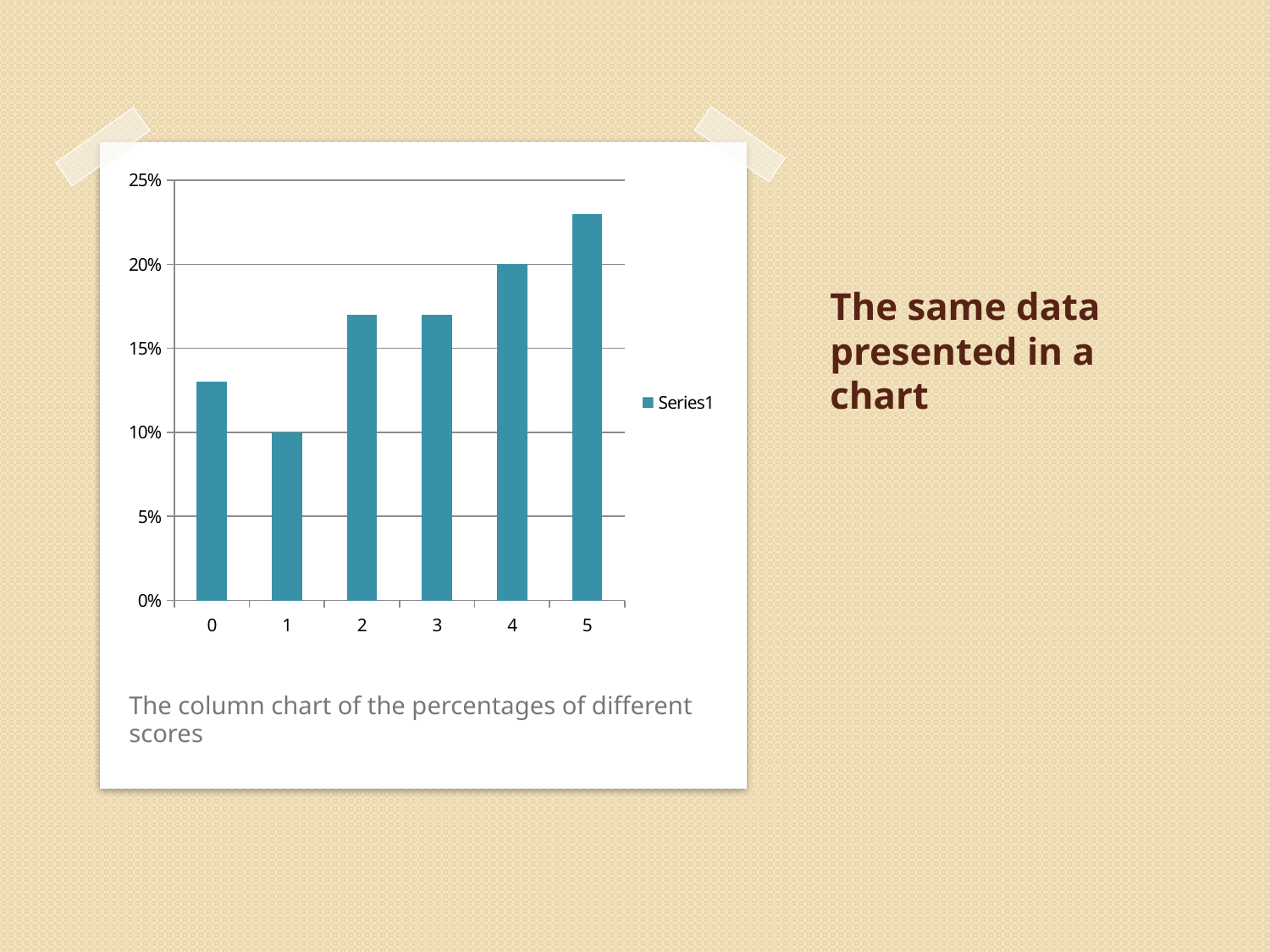
Which is larger, the value for category 0 or the value for category 2? category 2 Which category has the highest bar? 5 How many categories are shown on the x axis of the chart? 6 Is the value for category 0 greater or less than 15%? less Is the value for category 5 greater or less than 20%? greater Which category has the lowest bar? 1 From category 2 to category 5, do the values rise or fall? rise What kind of chart is shown on the slide? bar chart What is the value for category 1? 10% How many series does the chart's legend list? 1 What is the name of the series shown in the legend? Series1 What is the value for category 4? 20%